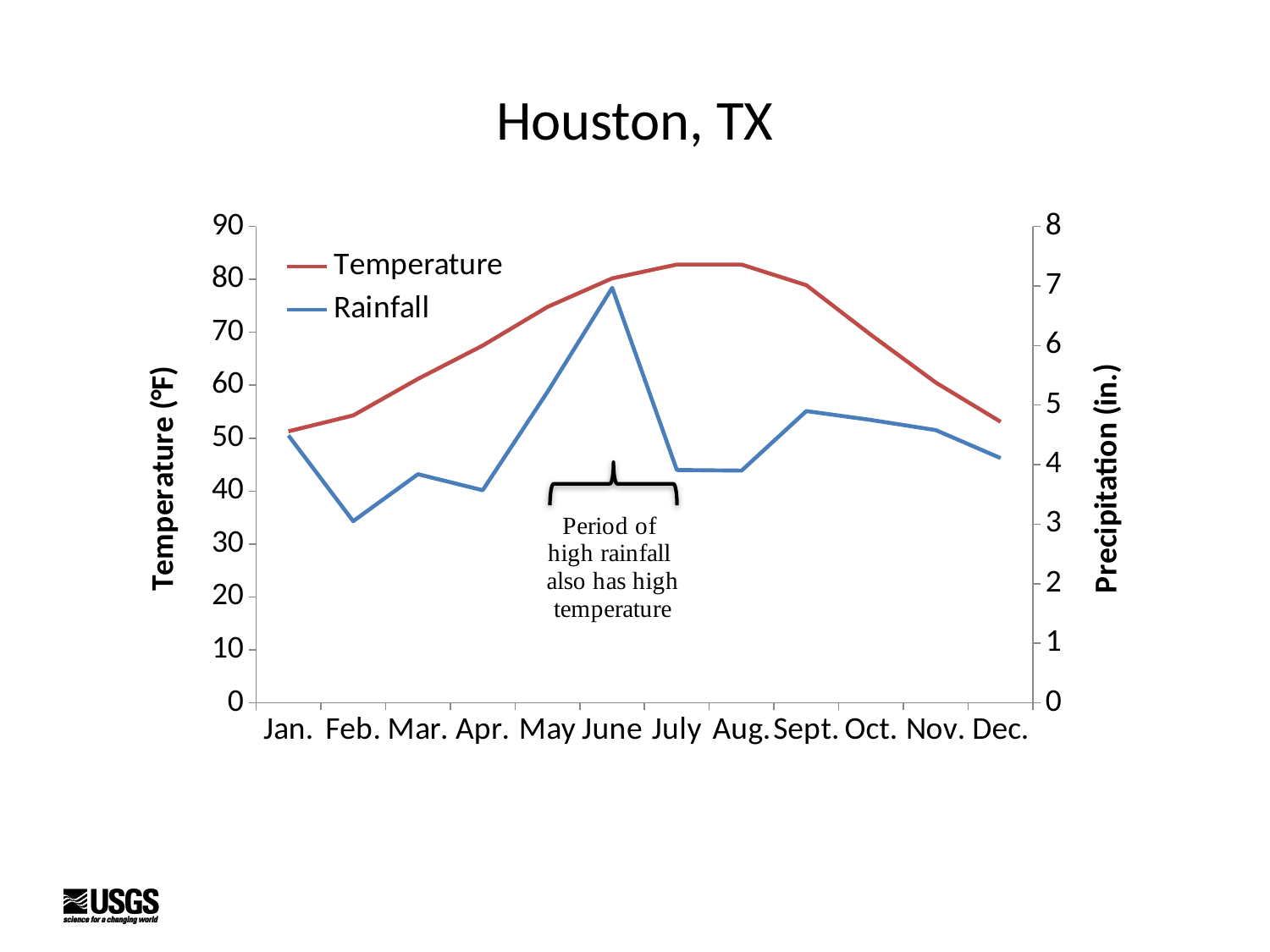
Is the Rainfall value for Feb. greater or less than 4? less In which month is Rainfall highest? June Is the Temperature value for June greater or less than 70? greater How many series does the legend list? 2 How many months are plotted along the x axis? 12 Which month has the higher Temperature, Apr. or Sept.? Sept. What is the title of the chart? Houston, TX Is the Temperature value for Jan. greater or less than 60? less In which month is Rainfall lowest? Feb. What kind of chart is shown on the slide? Line chart Does Temperature rise or fall from Jan. to July? Rise